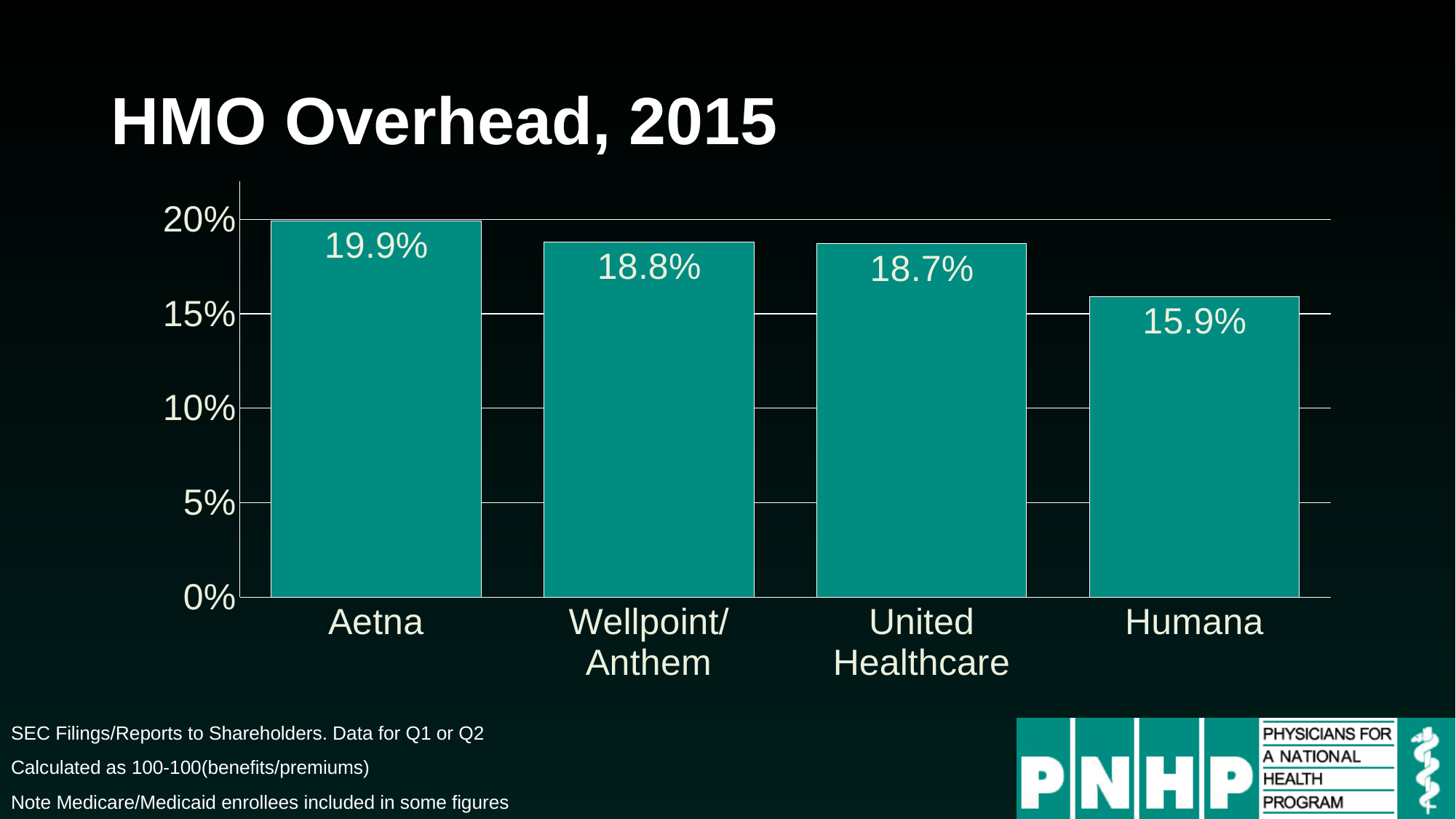
What is the overhead value for United Healthcare? 18.7% What kind of chart is shown on the slide? Bar chart Is the value for Humana greater or less than 15%? greater What is the overhead value for Wellpoint/Anthem? 18.8% What is the title of the chart? HMO Overhead, 2015 What is the overhead value for Aetna? 19.9% How many companies are shown in the chart? 4 What is the difference between Aetna's and Humana's overhead? 4.0% Which company has the highest overhead? Aetna Which is larger, the overhead for Aetna or for Humana? Aetna What is the overhead value for Humana? 15.9% Which company has the lowest overhead? Humana